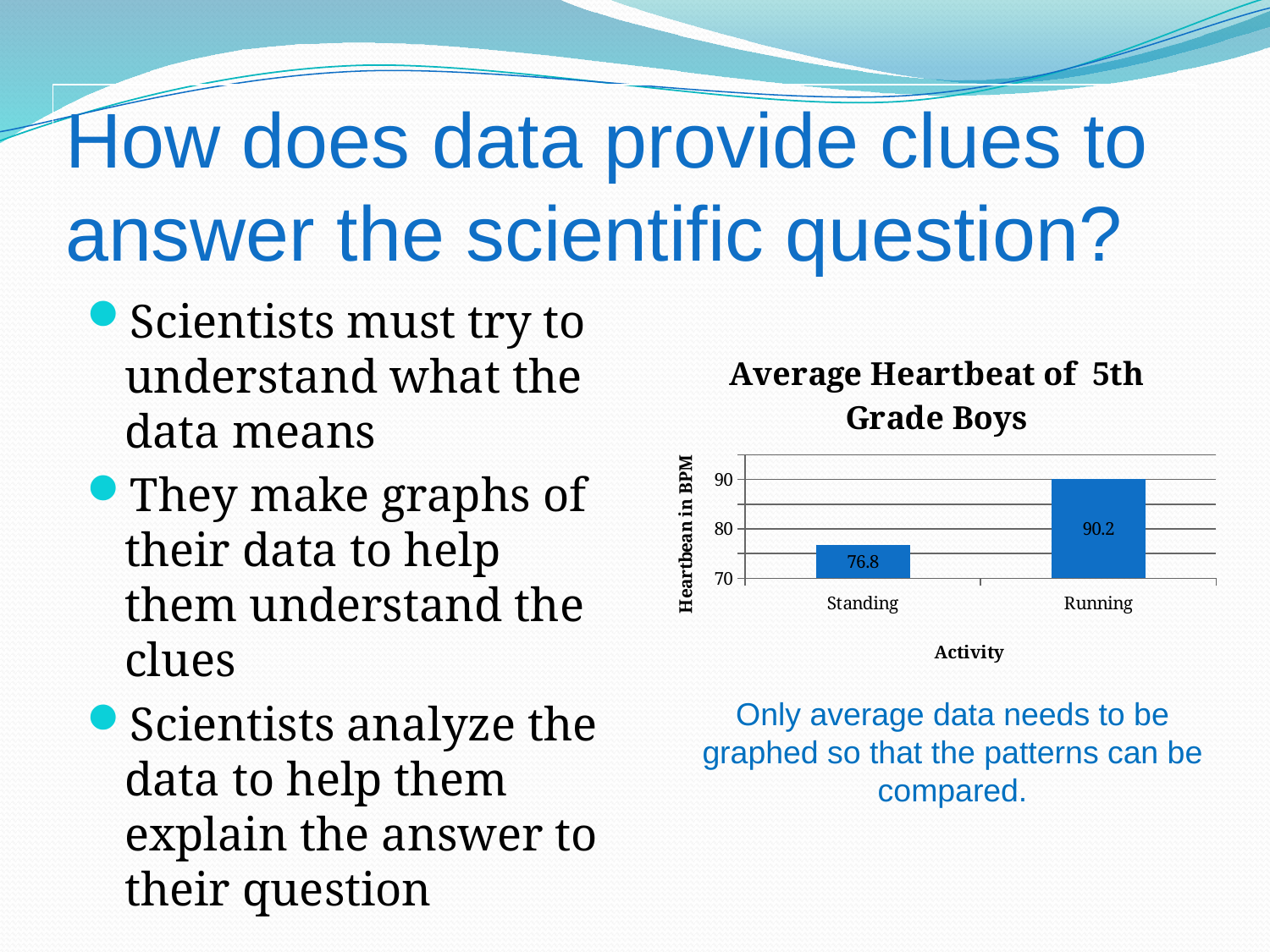
What is the difference in average heartbeat between Running and Standing? 13.4 Is the value for Standing greater or less than 80? less What is the label of the vertical axis of the chart? Heartbeat in BPM What is the average heartbeat in BPM for Standing? 76.8 What is the average heartbeat in BPM for Running? 90.2 Is the value for Running greater or less than 90? greater What kind of chart is shown on the slide? bar chart Which activity has the lowest average heartbeat? Standing How many activities are shown on the chart? 2 Which activity has the highest average heartbeat? Running Which has a larger average heartbeat, Standing or Running? Running What is the title of the chart? Average Heartbeat of 5th Grade Boys